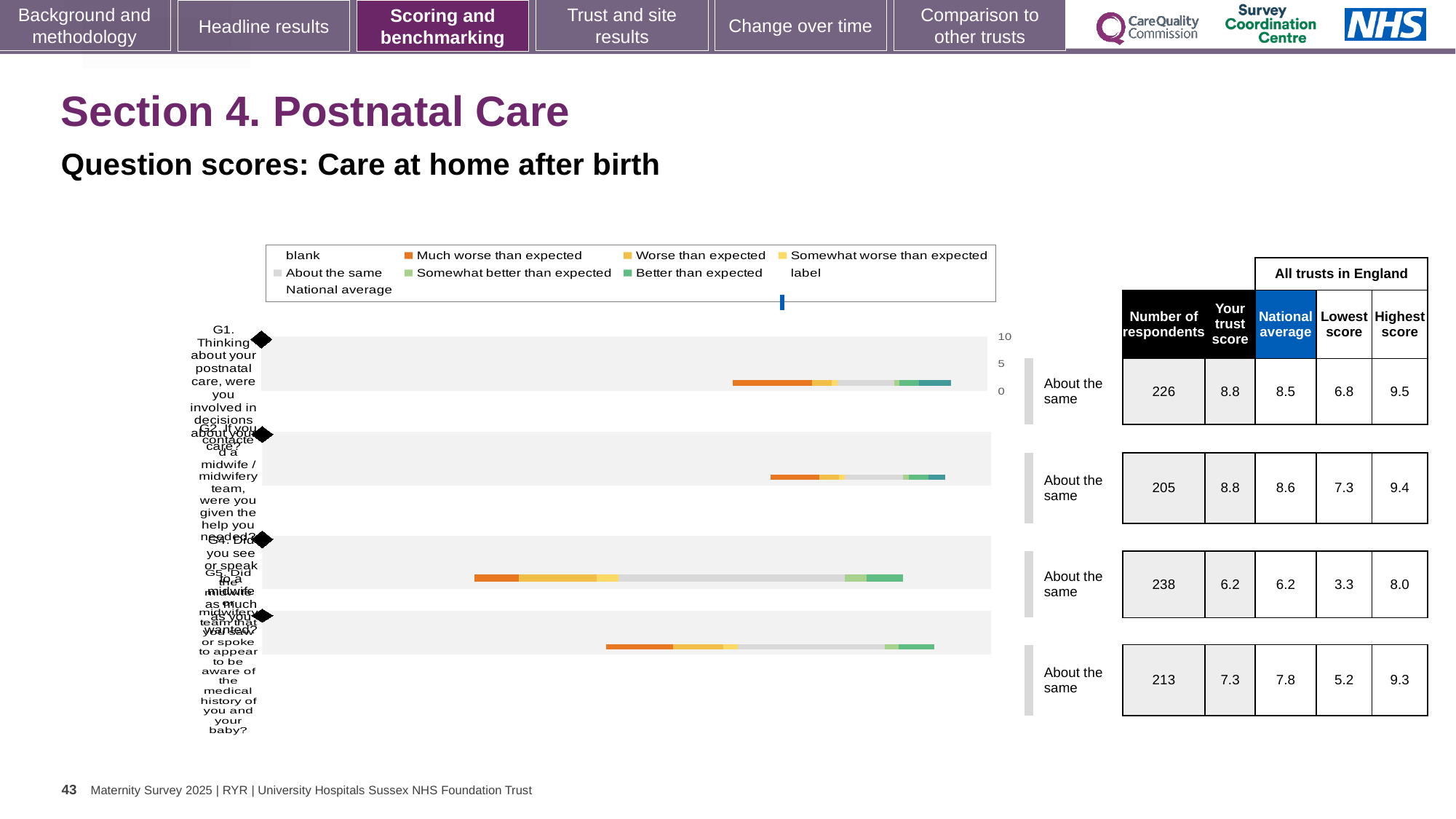
How many question bars are plotted in the chart? 4 In the table beside the chart, what is the 'Your trust score' for the first (top) question row? 8.8 In the table beside the chart, what is the highest score for the third question row? 8.0 Which question row has the highest number of respondents in the table beside the chart? the third row (238) For the first (top) question row, which is larger: the trust score or the national average? the trust score (8.8) What colour represents 'Much worse than expected' in the chart legend? orange In the table beside the chart, what is the number of respondents for the first (top) question row? 226 What benchmark category is shown next to every bar in the chart? About the same Which question row has the lowest 'Your trust score' in the table beside the chart? the third row (6.2) For the fourth (bottom) question row, what is the difference between the national average and the trust score? 0.5 What kind of chart is shown on the slide? bar chart In the table beside the chart, what is the lowest score for the fourth (bottom) question row? 5.2